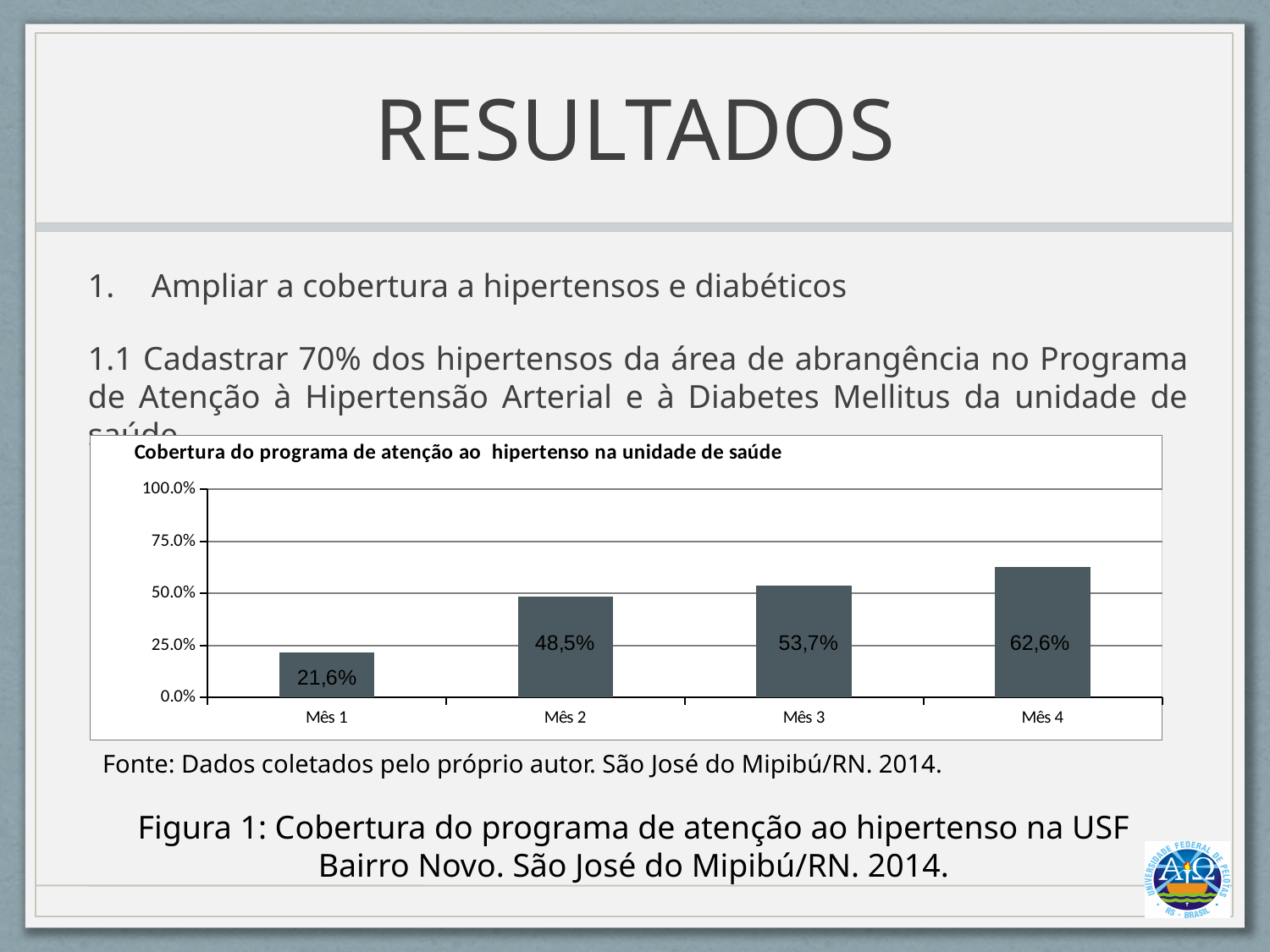
What is the value for Mês 4? 62,6% What is the title of the chart? Cobertura do programa de atenção ao hipertenso na unidade de saúde Is the value for Mês 4 greater or less than 50.0%? greater What is the value for Mês 1? 21,6% Which month has the lowest coverage? Mês 1 What kind of chart is shown? bar chart Do the values rise or fall from Mês 1 to Mês 4? rise What is the value for Mês 3? 53,7% What is the difference between the values for Mês 2 and Mês 1? 26,9% How many months are shown on the x axis? 4 Which is larger, the value for Mês 2 or the value for Mês 3? Mês 3 Which month has the highest coverage? Mês 4